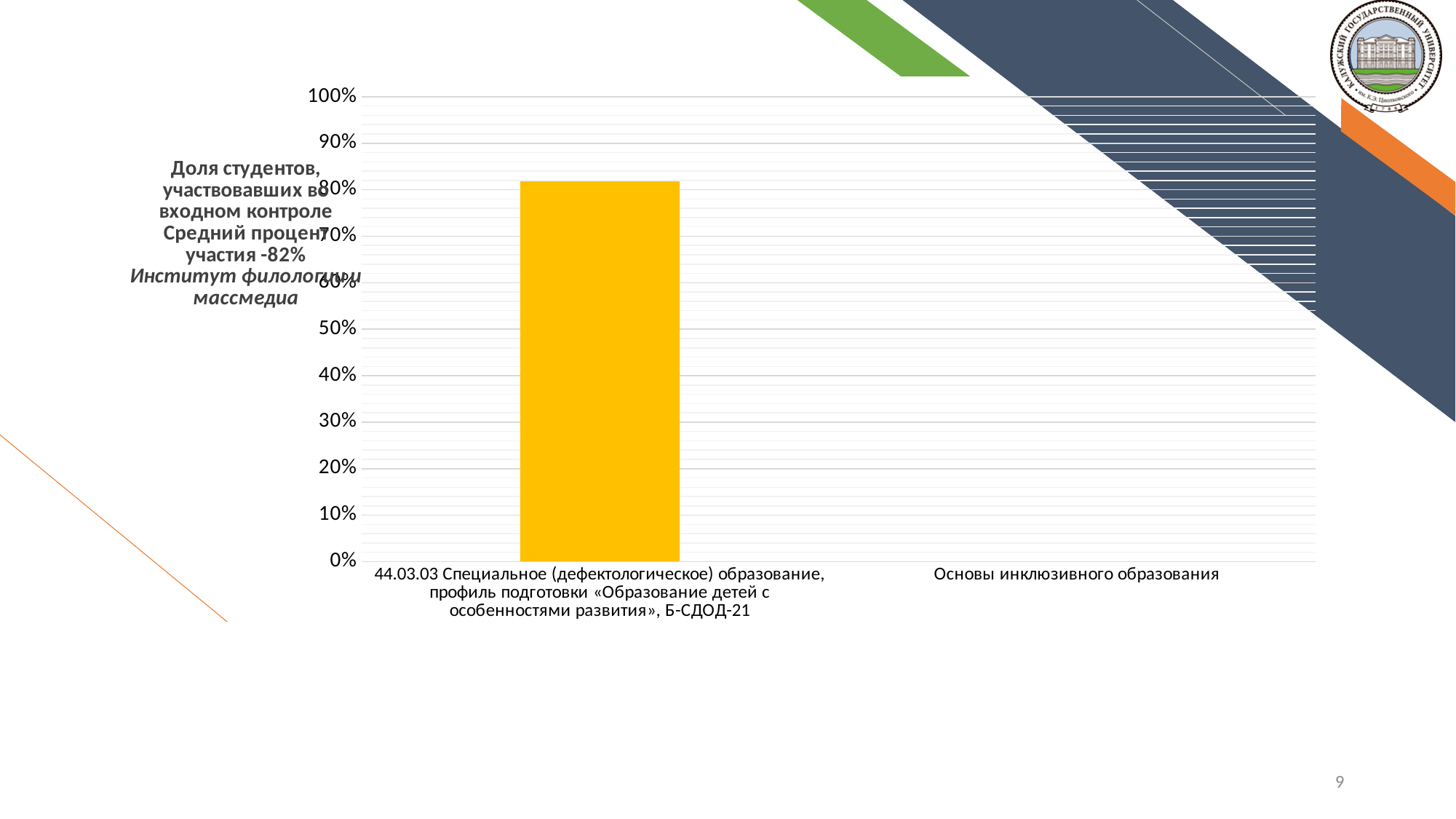
What colour is the bar plotted on the chart? yellow Which category on the x axis has a visible bar? 44.03.03 Специальное (дефектологическое) образование, профиль подготовки «Образование детей с особенностями развития», Б-СДОД-21 How many category labels are shown on the x axis of the chart? 2 Is the value for the bar labelled "44.03.03 Специальное (дефектологическое) образование, профиль подготовки «Образование детей с особенностями развития», Б-СДОД-21" greater or less than 70%? greater What kind of chart is shown on the slide? bar chart Is the value for the bar labelled "44.03.03 Специальное (дефектологическое) образование, профиль подготовки «Образование детей с особенностями развития», Б-СДОД-21" greater or less than 50%? greater Is the value for the bar labelled "44.03.03 Специальное (дефектологическое) образование, профиль подготовки «Образование детей с особенностями развития», Б-СДОД-21" greater or less than 90%? less What is the highest value shown on the chart's vertical axis? 100%